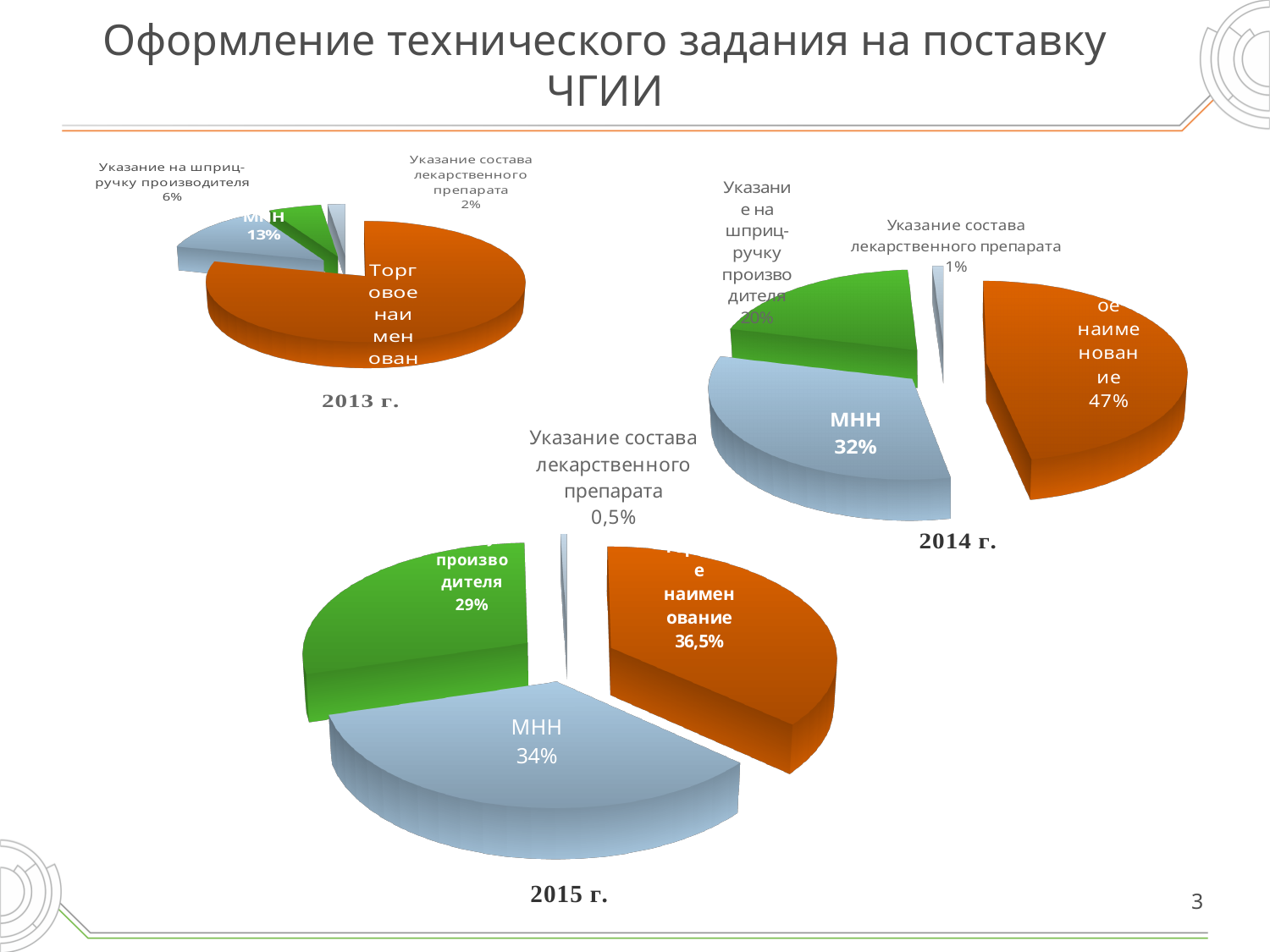
In the 2013 г. pie chart, what share does МНН have? 13% In the 2015 г. pie chart, what share does Указание состава лекарственного препарата have? 0,5% How many slices does the 2015 г. pie chart have? 4 In the 2013 г. pie chart, which category has the largest slice? Торговое наименование In the 2014 г. pie chart, what share does МНН have? 32% In the 2015 г. pie chart, what share does Указание на шприц-ручку производителя have? 29% What type of chart is the 2014 г. chart? Pie chart In the 2013 г. pie chart, which is larger: Указание на шприц-ручку производителя or Указание состава лекарственного препарата? Указание на шприц-ручку производителя In the 2014 г. pie chart, what share does Торговое наименование have? 47% In the 2014 г. pie chart, which category has the smallest slice? Указание состава лекарственного препарата In the 2014 г. pie chart, what is the difference in percentage points between Торговое наименование and МНН? 15 In the 2015 г. pie chart, which category has the largest slice? Торговое наименование